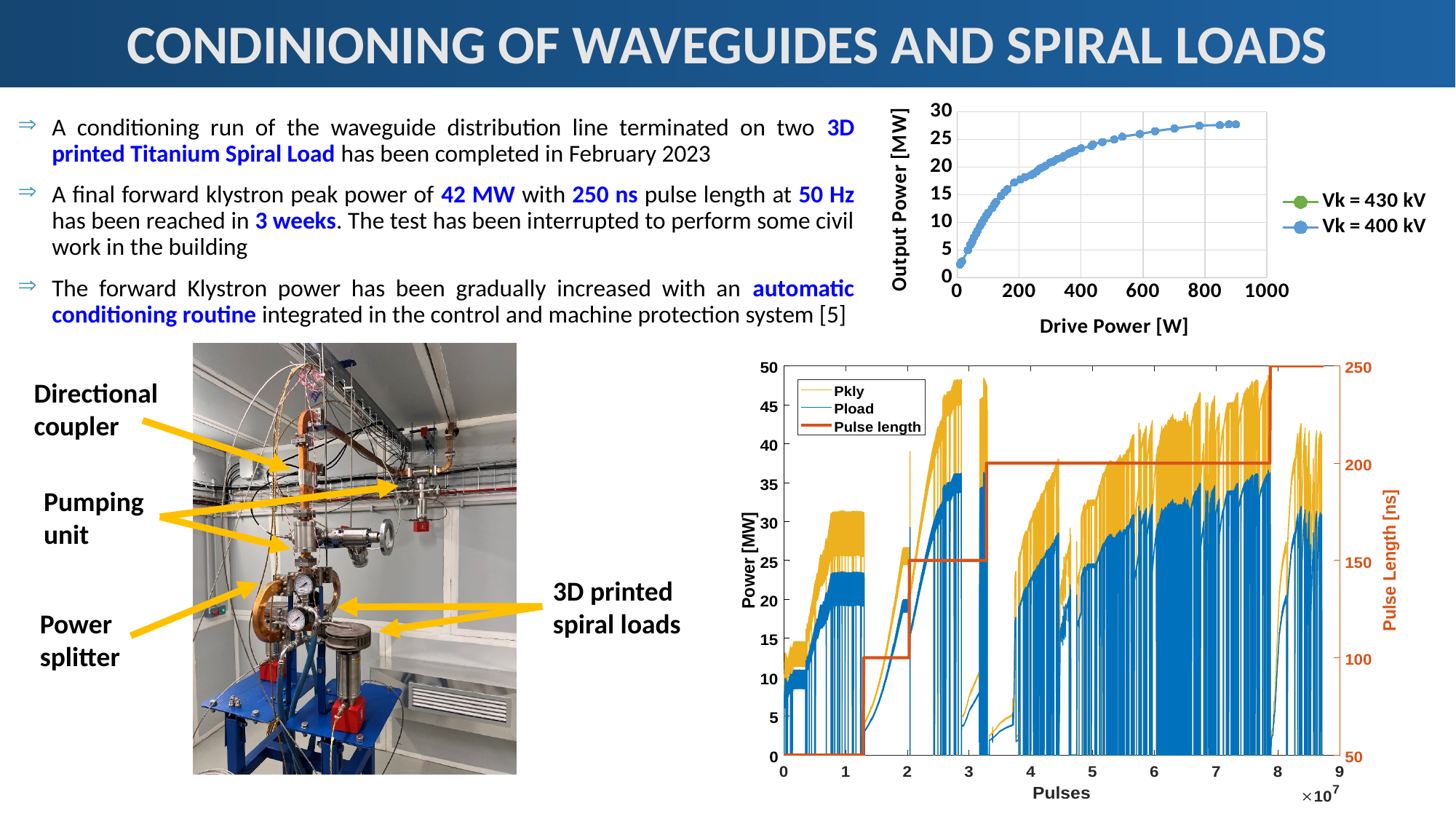
In the bottom-right chart of Power versus Pulses, what is the pulse length at about 5 x 10^7 pulses? 200 In the top-right chart of Output Power versus Drive Power, does the output power rise or fall as drive power increases? rise In the bottom-right chart of Power versus Pulses, what is the label of the right-hand y axis? Pulse Length [ns] In the top-right chart of Output Power versus Drive Power, is the output power at a drive power of 800 W greater or less than 25 MW? greater In the bottom-right chart of Power versus Pulses, what is the pulse length at the start of the run (near 0 pulses)? 50 In the top-right chart of Output Power versus Drive Power, what is the label of the x axis? Drive Power [W] In the top-right chart of Output Power versus Drive Power, what are the two legend entries? Vk = 430 kV and Vk = 400 kV In the top-right chart of Output Power versus Drive Power, is the output power at a drive power of 200 W greater or less than 15 MW? greater In the bottom-right chart of Power versus Pulses, how many entries does the legend list? 3 In the bottom-right chart of Power versus Pulses, which is larger at about 6 x 10^7 pulses, Pkly or Pload? Pkly In the bottom-right chart of Power versus Pulses, does the pulse length rise or fall as the number of pulses increases? rise In the top-right chart of Output Power versus Drive Power, how many series does the legend list? 2